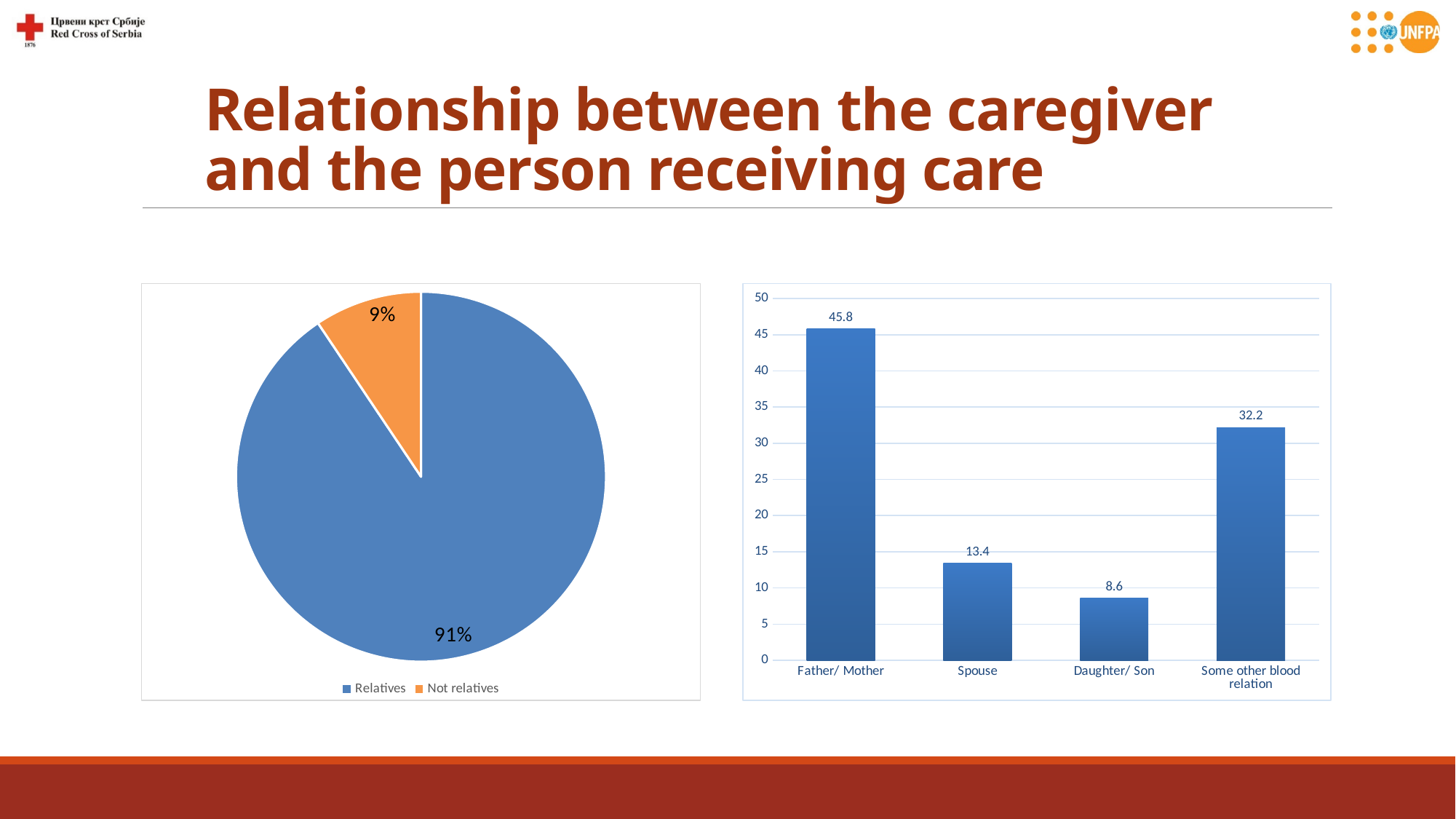
In the bar chart on the right, which category has the lowest value? Daughter/ Son In the bar chart on the right, what is the value for Spouse? 13.4 In the bar chart on the right, what is the value for Father/ Mother? 45.8 In the pie chart on the left, what share is labelled for Relatives? 91% In the bar chart on the right, what is the difference between the values for Father/ Mother and Some other blood relation? 13.6 What kind of chart is the chart on the left of the slide? pie chart How many entries does the legend of the pie chart on the left list? 2 In the bar chart on the right, what is the value for Daughter/ Son? 8.6 In the bar chart on the right, which category has the highest value? Father/ Mother In the pie chart on the left, what share is labelled for Not relatives? 9% What kind of chart is the chart on the right of the slide? bar chart How many categories are shown on the x axis of the bar chart on the right? 4